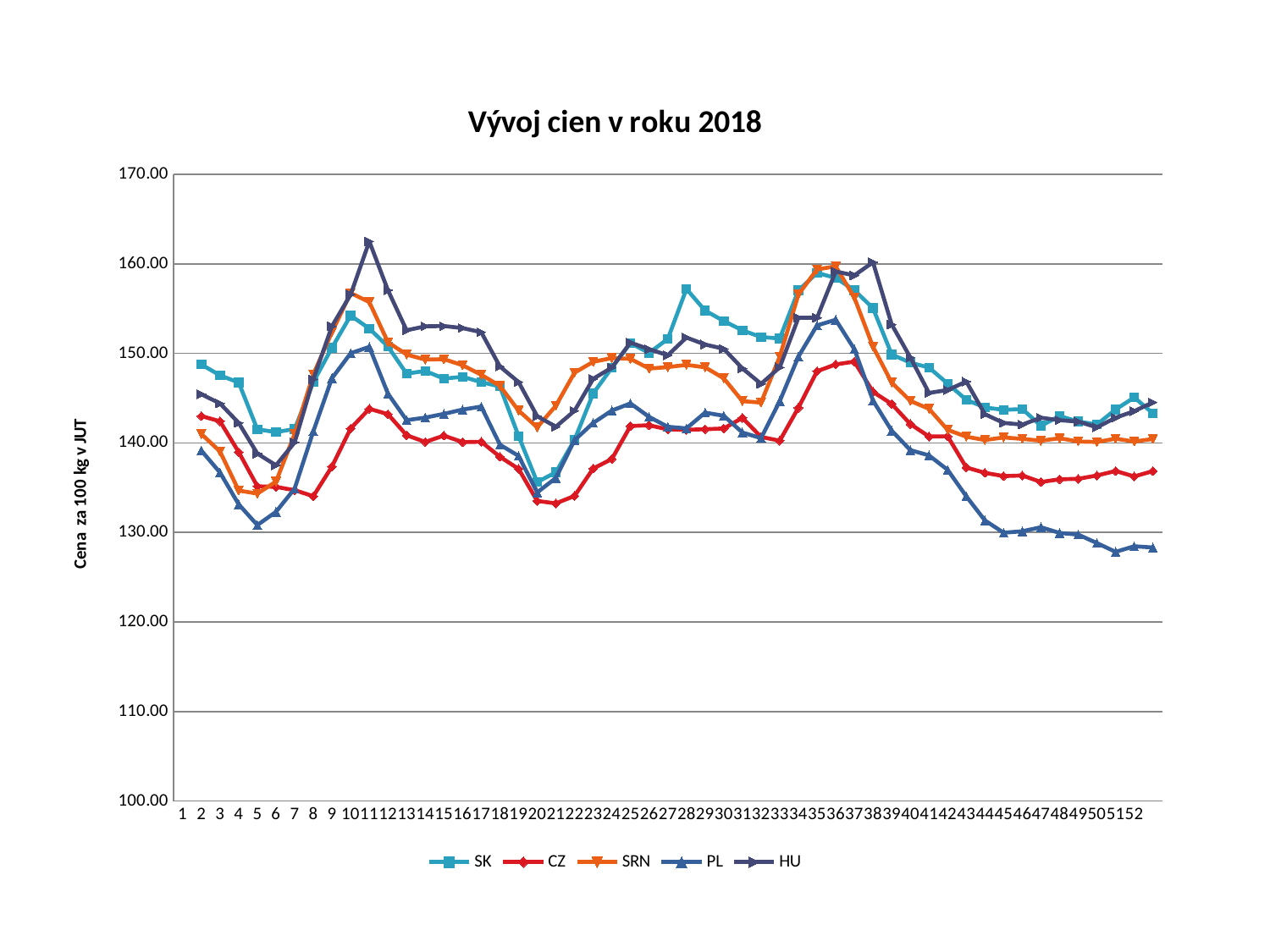
How many series does the legend list? 5 What kind of chart is shown on the slide? line chart Is the value for CZ at week 21 greater or less than 140.00? less At week 28, which is larger, the value for SK or the value for CZ? SK Which series has the highest value at week 11? HU What is the label on the vertical axis? Cena za 100 kg v JUT Is the value for PL at week 50 greater or less than 130.00? less Is the value for SK at week 2 greater or less than 140.00? greater Which series has the lowest value at week 52? PL What is the title of the chart? Vývoj cien v roku 2018